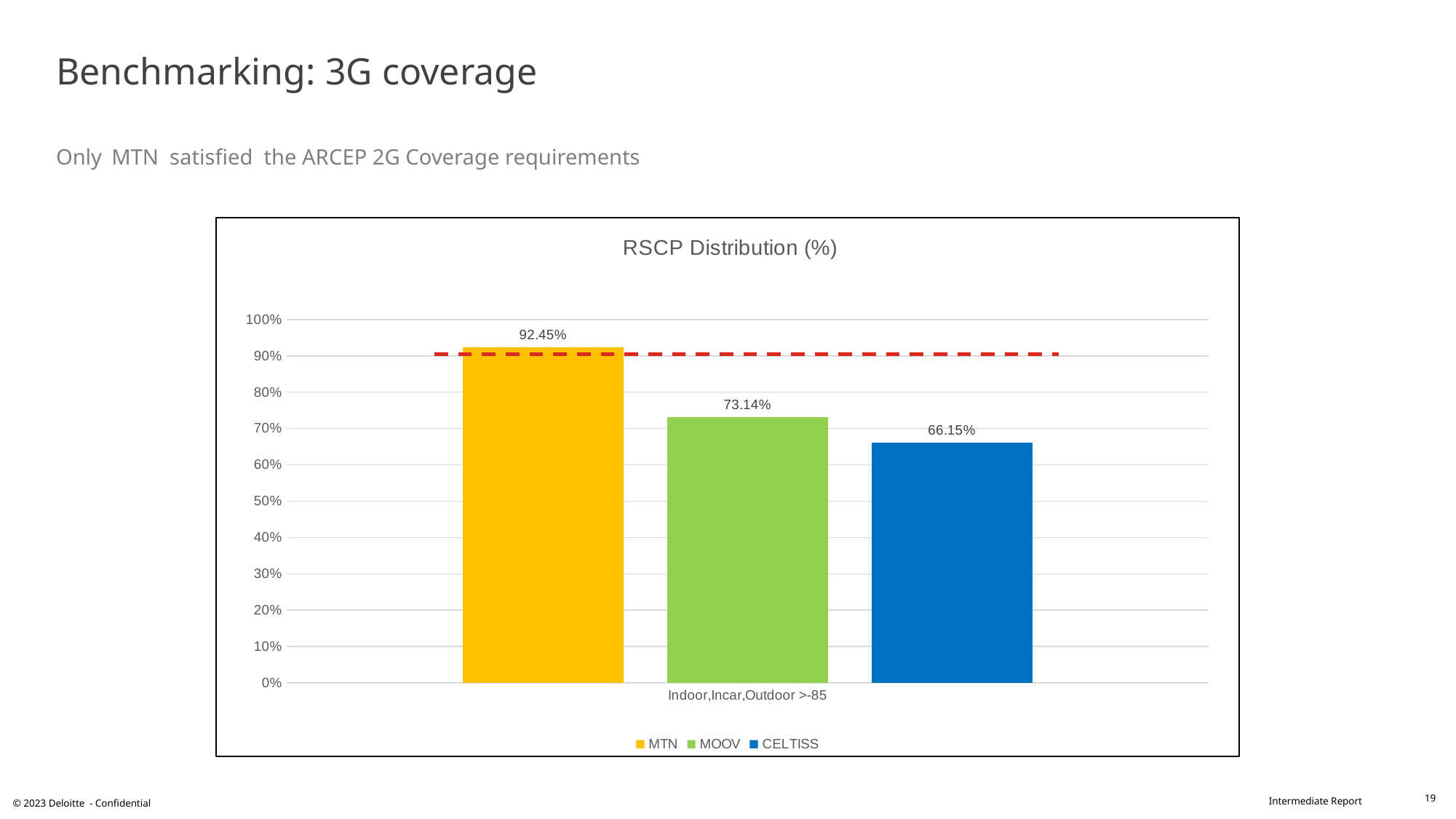
What is the difference between the MTN and MOOV values? 19.31% Which operator has the highest RSCP Distribution value? MTN What is the value for MOOV in the RSCP Distribution chart? 73.14% What kind of chart is shown on the slide? Bar chart What is the value for CELTISS in the RSCP Distribution chart? 66.15% How many series does the legend list? 3 Which operator has the lowest RSCP Distribution value? CELTISS What is the value for MTN in the RSCP Distribution chart? 92.45% What is the difference between the MOOV and CELTISS values? 6.99% What is the title of the chart? RSCP Distribution (%) Is the value for MTN greater or less than 90%? greater Which is larger, the value for MOOV or the value for CELTISS? MOOV